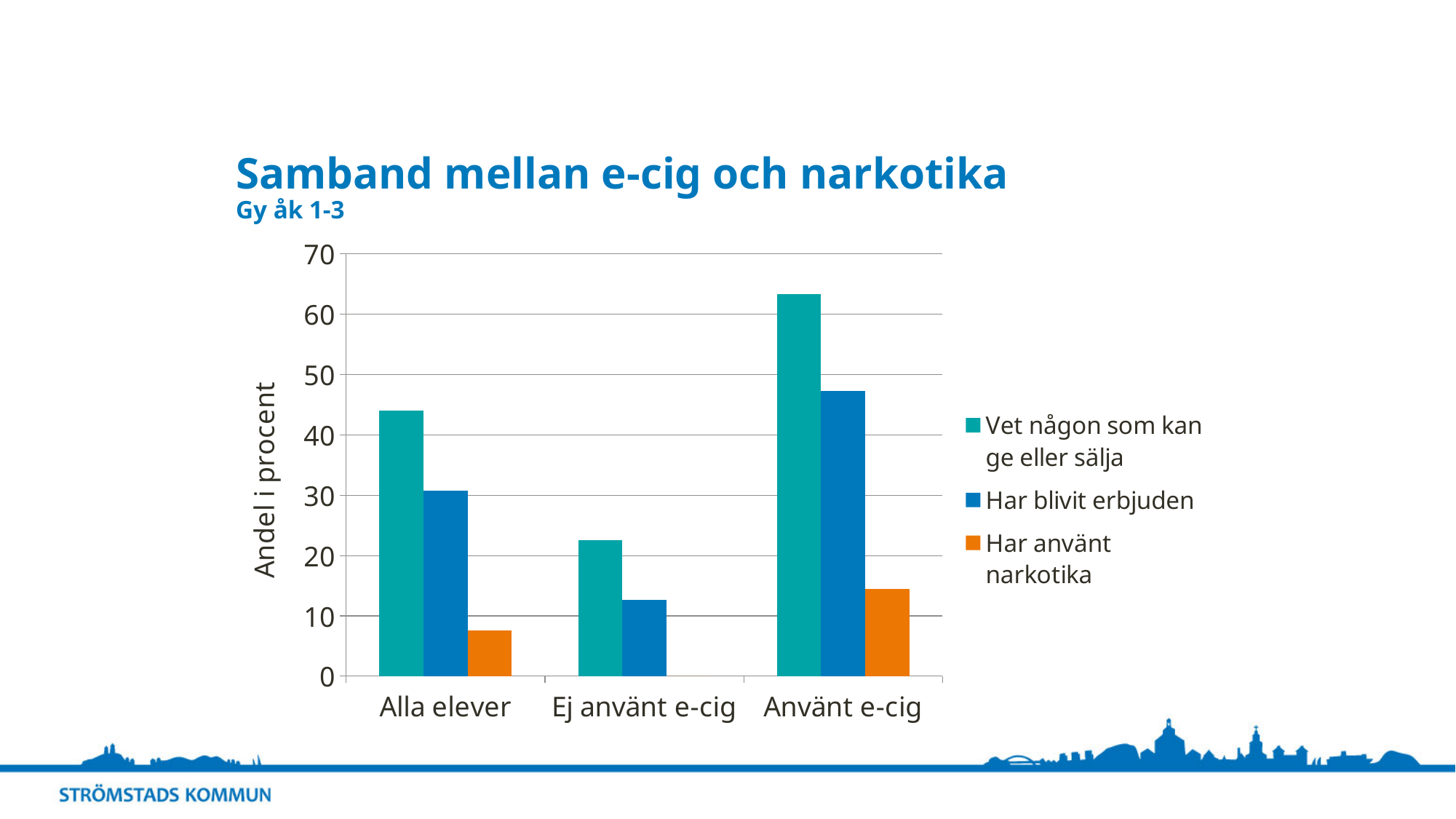
How many categories are shown on the x axis? 3 Which category has the lowest value for 'Har blivit erbjuden'? Ej använt e-cig Is the value for 'Har använt narkotika' in the 'Alla elever' category greater or less than 10? less Is the value for 'Har blivit erbjuden' in the 'Alla elever' category greater or less than 40? less Is the value for 'Vet någon som kan ge eller sälja' in the 'Använt e-cig' category greater or less than 60? greater Which is larger: 'Har blivit erbjuden' for 'Alla elever' or 'Vet någon som kan ge eller sälja' for 'Ej använt e-cig'? 'Har blivit erbjuden' for 'Alla elever' What is the title of the chart on the slide? Samband mellan e-cig och narkotika How many series does the legend list? 3 What is the label on the y axis? Andel i procent Which category has the highest value for 'Vet någon som kan ge eller sälja'? Använt e-cig What kind of chart is shown on the slide? Bar chart